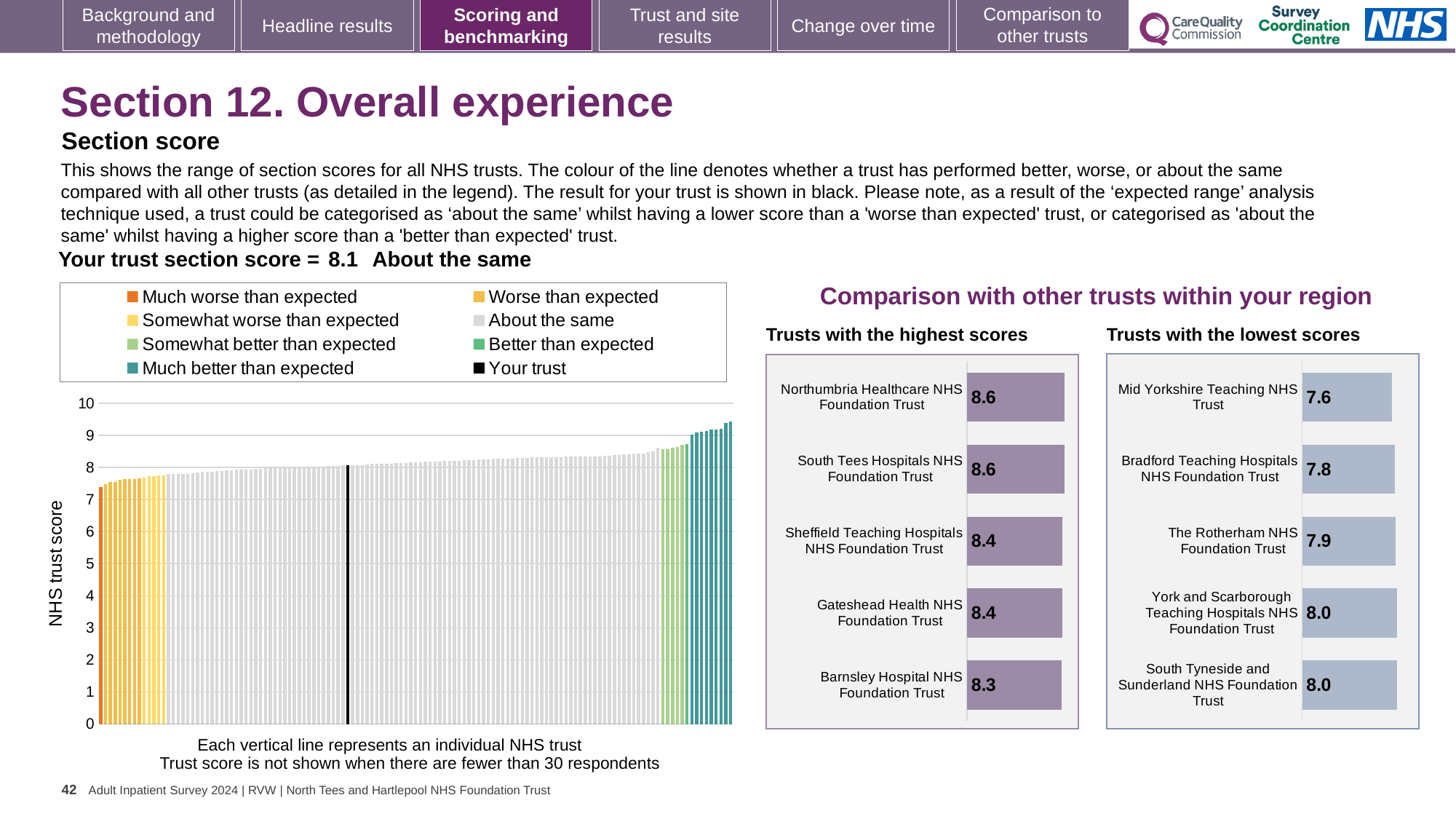
In the 'Trusts with the lowest scores' chart, what is the difference between the scores of South Tyneside and Sunderland NHS Foundation Trust and Mid Yorkshire Teaching NHS Trust? 0.4 In the 'Trusts with the highest scores' chart, what is the score for Northumbria Healthcare NHS Foundation Trust? 8.6 How many entries does the legend of the NHS trust score chart on the left list? 8 In the 'Trusts with the lowest scores' chart, what is the score for Mid Yorkshire Teaching NHS Trust? 7.6 In the 'Trusts with the lowest scores' chart, which trust has the lowest score? Mid Yorkshire Teaching NHS Trust In the 'Trusts with the highest scores' chart, which has the higher score: Sheffield Teaching Hospitals NHS Foundation Trust or Barnsley Hospital NHS Foundation Trust? Sheffield Teaching Hospitals NHS Foundation Trust In the 'Trusts with the highest scores' chart, what is the score for Barnsley Hospital NHS Foundation Trust? 8.3 How many trusts are shown in the 'Trusts with the lowest scores' chart? 5 In the NHS trust score chart on the left, is the value for 'Your trust' greater or less than 5? greater In the 'Trusts with the highest scores' chart, what is the difference between the scores of Northumbria Healthcare NHS Foundation Trust and Barnsley Hospital NHS Foundation Trust? 0.3 What kind of chart is the NHS trust score chart on the left of the slide? Bar chart In the NHS trust score chart on the left, do the values rise or fall from left to right along the x axis? Rise